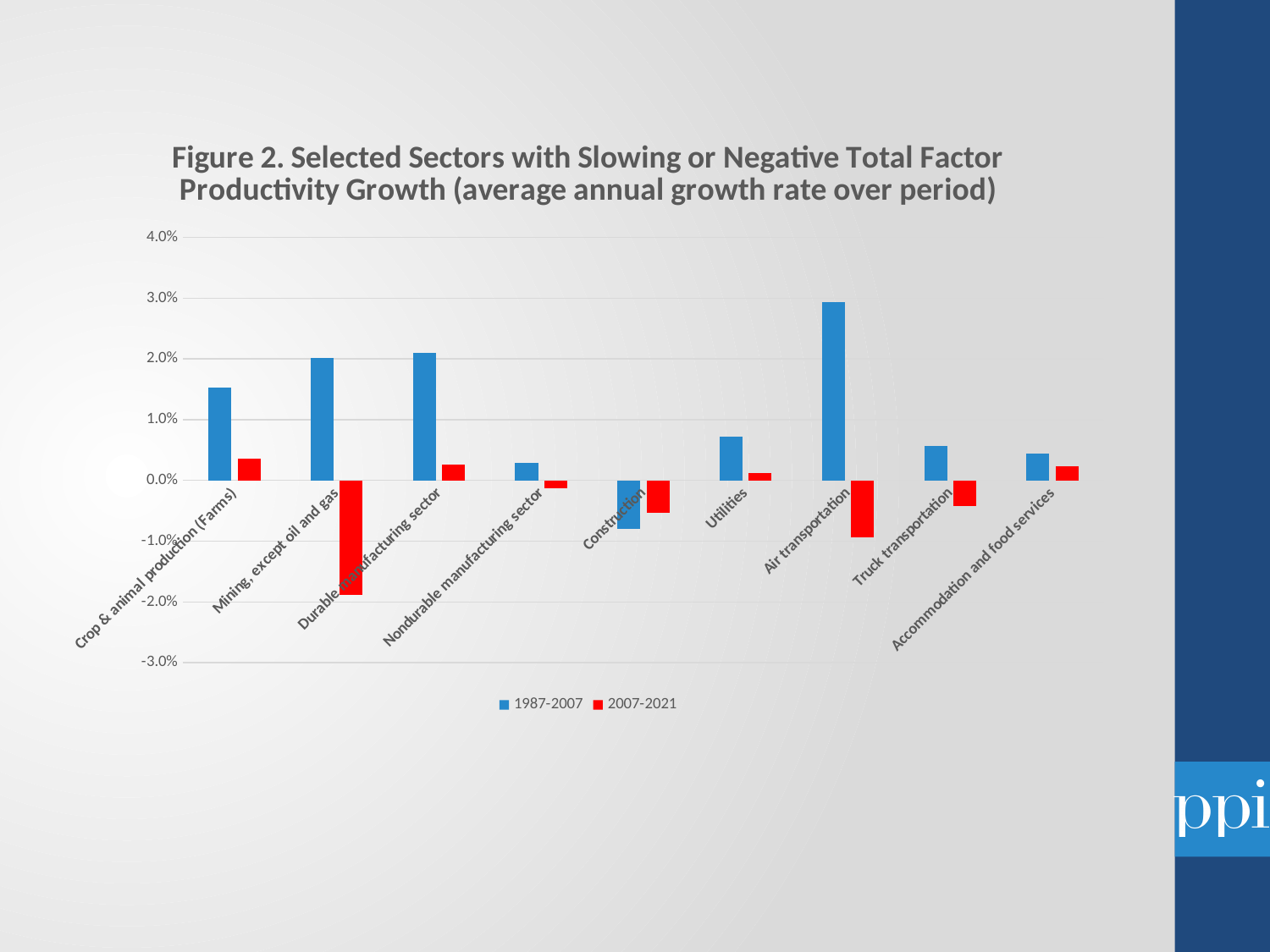
Is the 2007-2021 value for Mining, except oil and gas greater or less than -1.0%? less Which sector has the highest value for the 1987-2007 series? Air transportation How many sectors are shown on the x axis? 9 How many series does the legend list? 2 For the 1987-2007 series, which is larger: Mining, except oil and gas or Crop & animal production (Farms)? Mining, except oil and gas What kind of chart is shown on the slide? bar chart Which colour represents the 2007-2021 series? red Is the 1987-2007 value for Construction greater or less than 0.0%? less Is the 1987-2007 value for Durable manufacturing sector greater or less than 1.0%? greater Which sector has the lowest value for the 1987-2007 series? Construction Which sector has the lowest value for the 2007-2021 series? Mining, except oil and gas